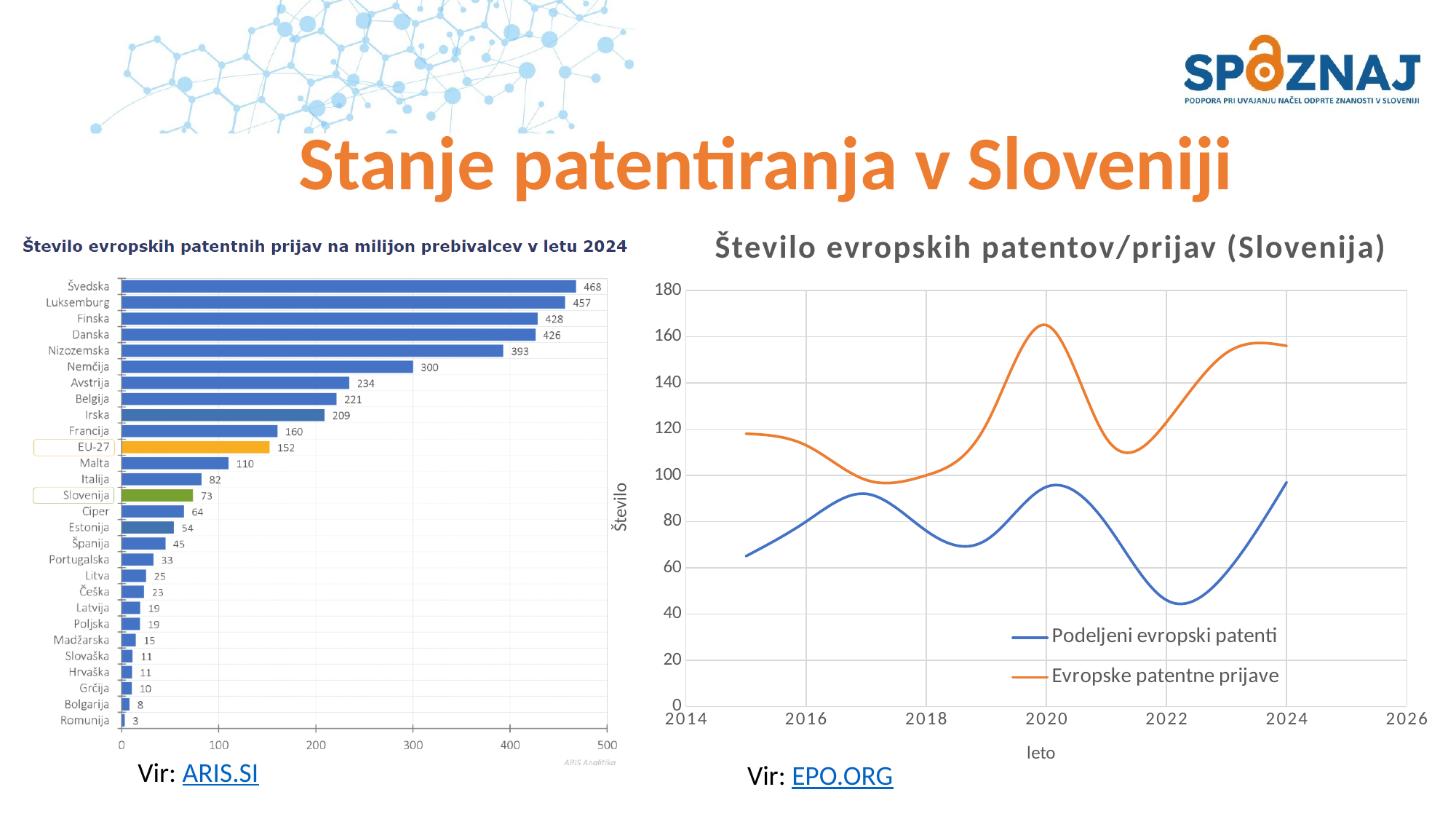
On the right chart, which series is drawn in orange? Evropske patentne prijave On the left chart, how many categories (bars) are shown? 28 On the left chart, what is the value for EU-27? 152 On the left chart, what is the difference between the values for EU-27 and Slovenija? 79 What kind of chart is the left chart? Bar chart On the right chart, is the value for Evropske patentne prijave in 2020 greater or less than 140? greater On the right chart, is the value for Podeljeni evropski patenti in 2022 greater or less than 60? less On the left chart, which country has the highest value? Švedska On the left chart, which has a larger value, Nemčija or Nizozemska? Nizozemska On the left chart (Število evropskih patentnih prijav na milijon prebivalcev v letu 2024), what is the value for Slovenija? 73 On the left chart, which country has the lowest value? Romunija On the right chart (Število evropskih patentov/prijav (Slovenija)), how many series does the legend list? 2